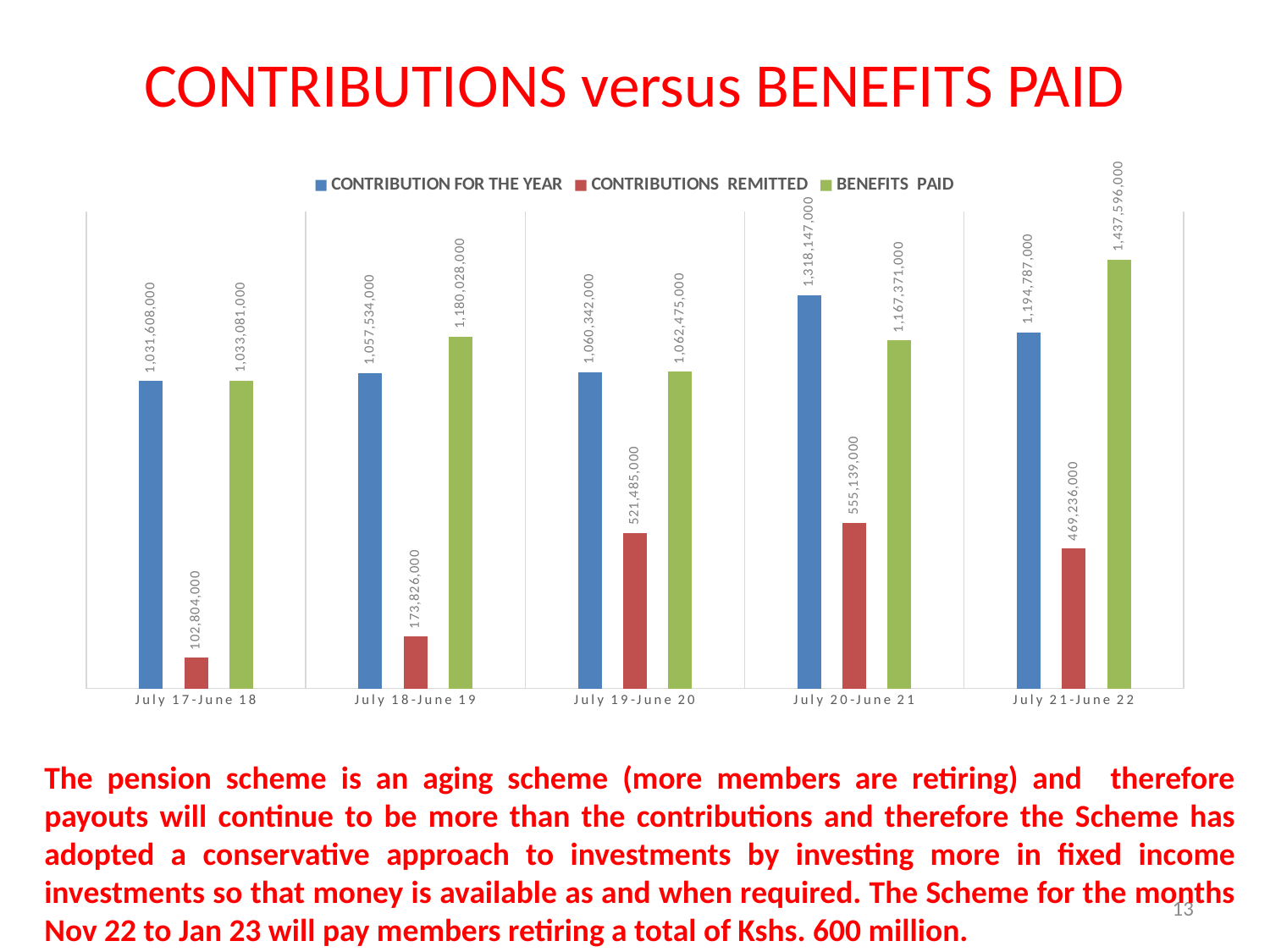
How many series does the legend list? 3 In which period is BENEFITS PAID the highest? July 21-June 22 What type of chart is shown on the slide? Bar chart What is the value of CONTRIBUTIONS REMITTED for July 17-June 18? 102,804,000 In which period is CONTRIBUTION FOR THE YEAR the highest? July 20-June 21 What is the value of CONTRIBUTION FOR THE YEAR for July 19-June 20? 1,060,342,000 What is the difference between BENEFITS PAID and CONTRIBUTION FOR THE YEAR for July 21-June 22? 242,809,000 In which period is CONTRIBUTIONS REMITTED the lowest? July 17-June 18 What is the value of BENEFITS PAID for July 21-June 22? 1,437,596,000 How many periods are shown on the x axis? 5 What is the value of CONTRIBUTIONS REMITTED for July 20-June 21? 555,139,000 For July 20-June 21, which is larger: CONTRIBUTION FOR THE YEAR or BENEFITS PAID? CONTRIBUTION FOR THE YEAR